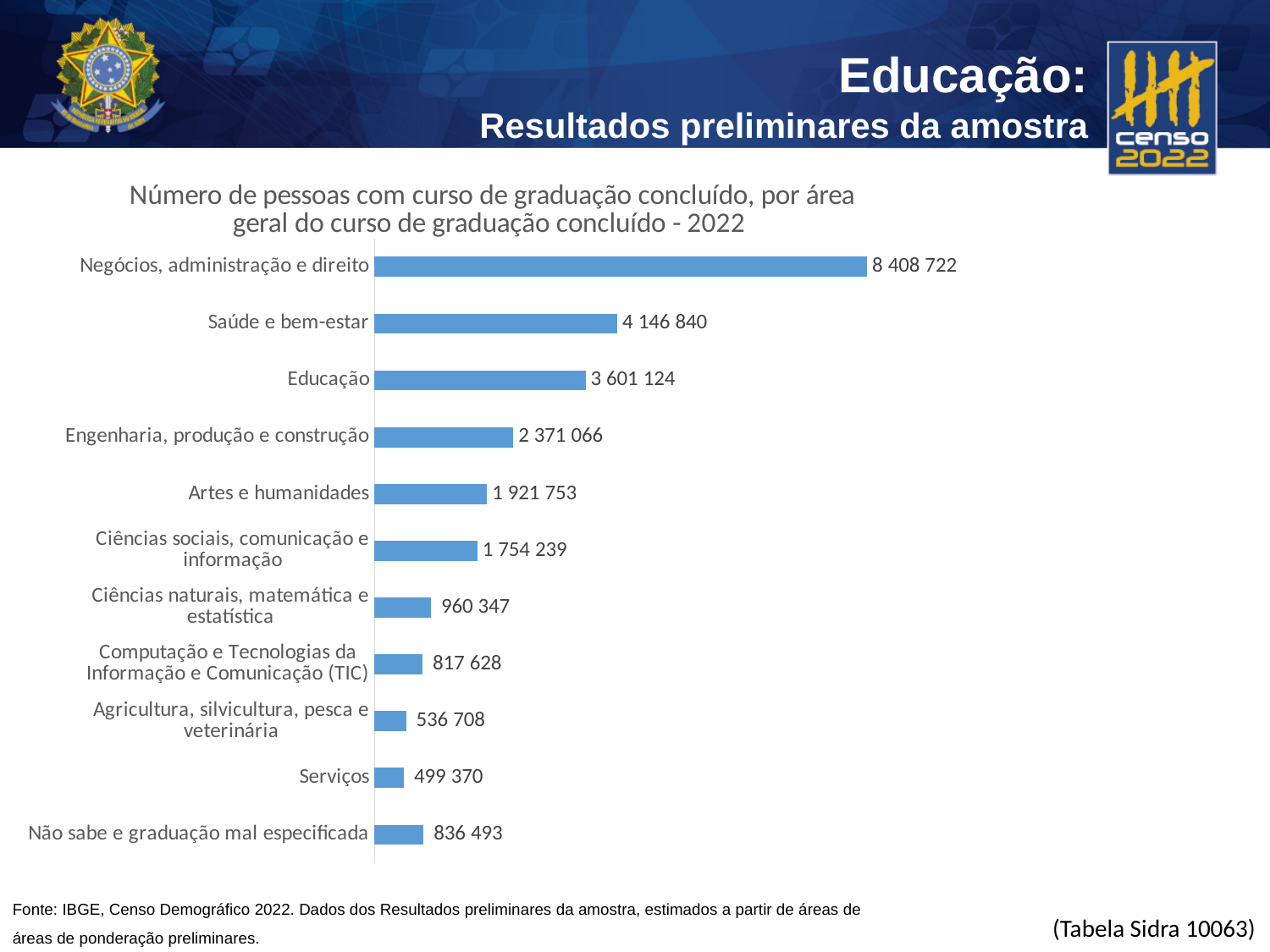
What value is shown for Serviços? 499 370 What is the difference between the values for Artes e humanidades and Ciências sociais, comunicação e informação? 167 514 What value is shown for Engenharia, produção e construção? 2 371 066 Which area has the lowest value in the chart? Serviços What type of chart is shown on the slide? Bar chart What is the number of people with a completed degree in Negócios, administração e direito? 8 408 722 What year does the chart title refer to? 2022 Which has a larger value: Computação e Tecnologias da Informação e Comunicação (TIC) or Não sabe e graduação mal especificada? Não sabe e graduação mal especificada Which area has the highest number of people with a completed degree? Negócios, administração e direito What is the difference between the values for Saúde e bem-estar and Educação? 545 716 What value is shown for Saúde e bem-estar? 4 146 840 How many areas (categories) are shown in the chart? 11